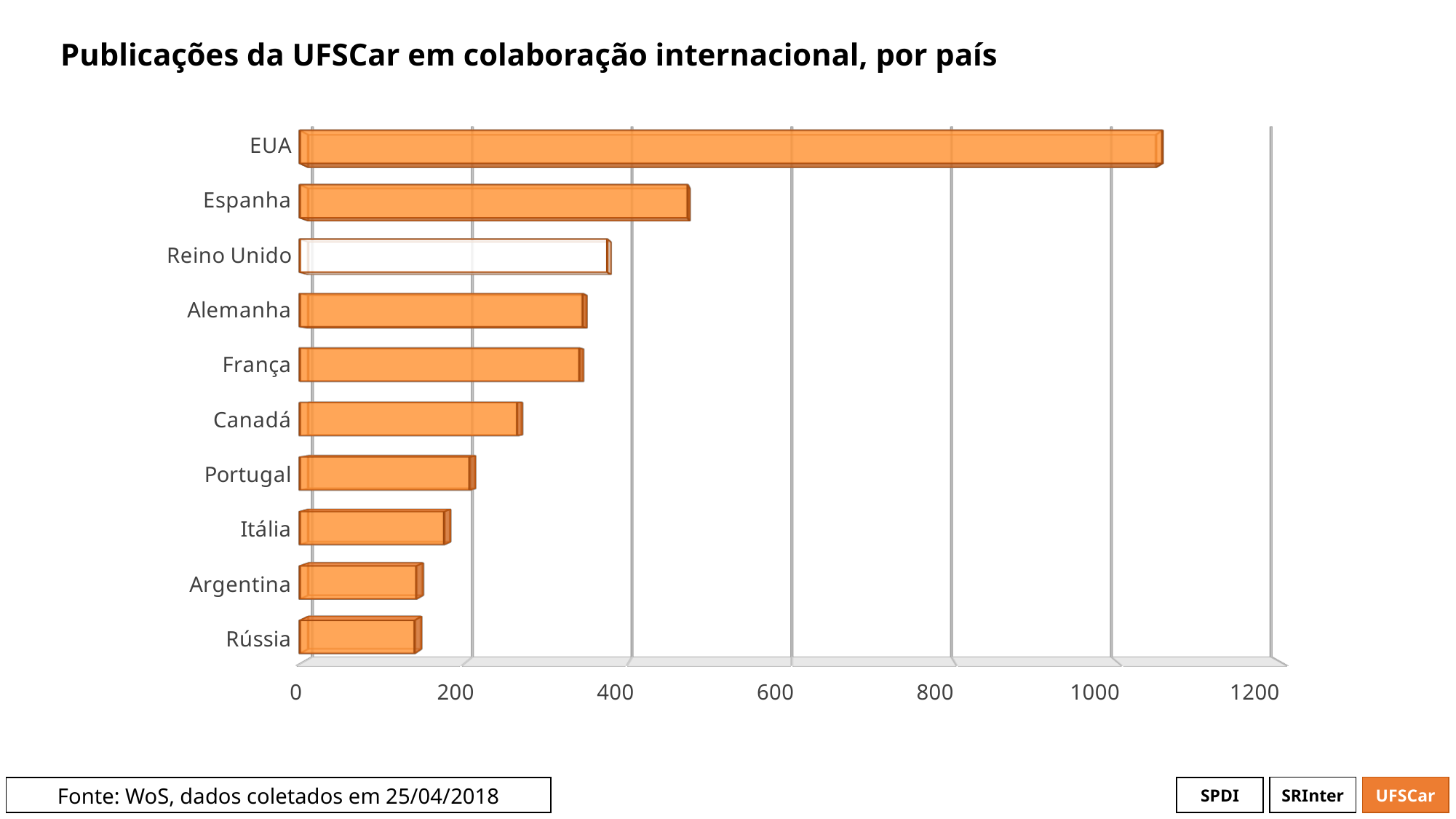
Is the value for Reino Unido greater or less than 400? less Is the value for Canadá greater or less than 200? greater Which has more publications, Canadá or Portugal? Canadá Which country has the highest number of publications in international collaboration? EUA Is the value for Itália greater or less than 200? less Which has more publications, Espanha or Reino Unido? Espanha What is the title of the chart? Publicações da UFSCar em colaboração internacional, por país How many countries are shown in the chart? 10 What kind of chart is shown on the slide? bar chart